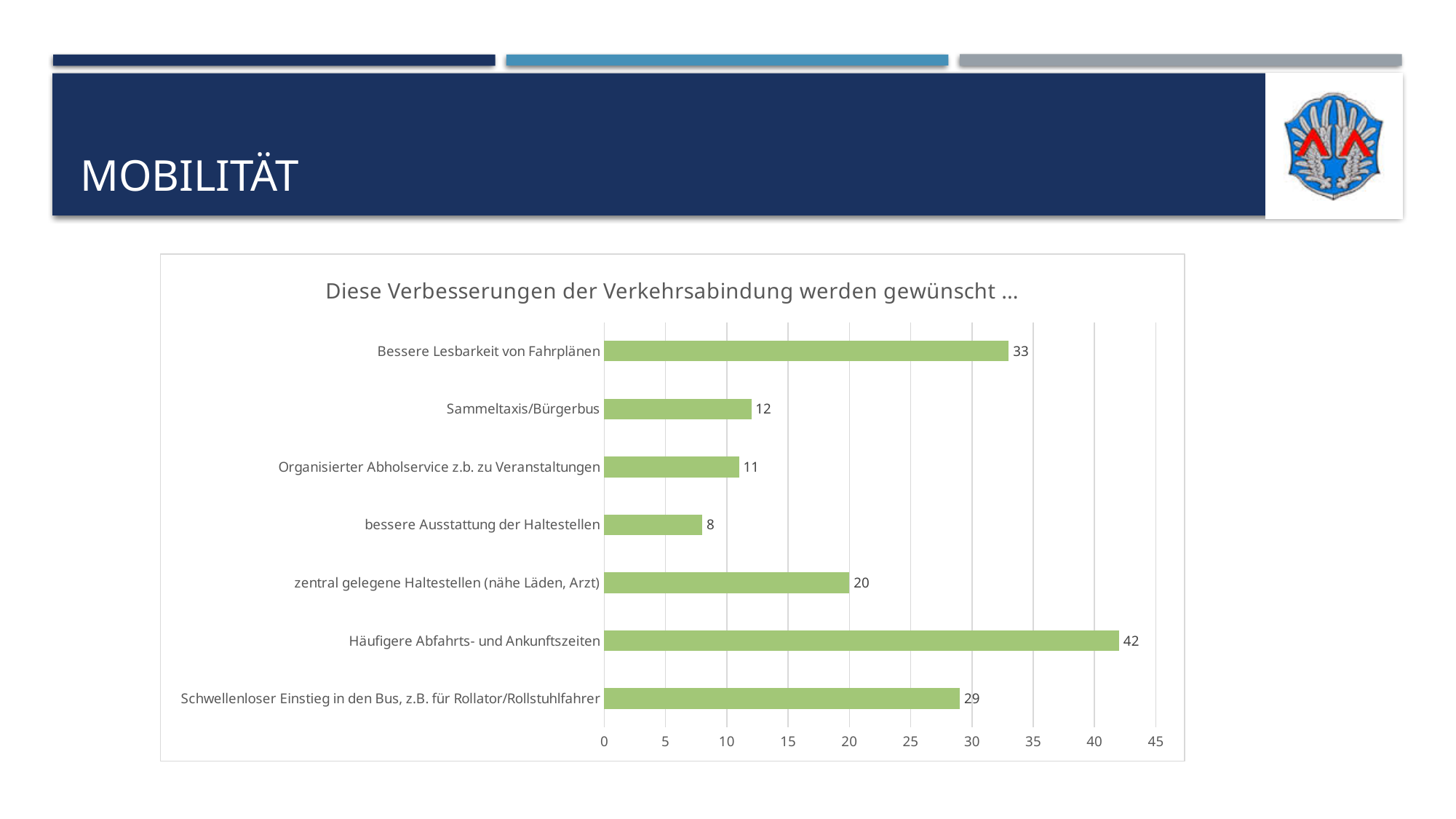
What colour are the bars in the chart? green What is the value for "Sammeltaxis/Bürgerbus"? 12 How many categories are shown in the chart? 7 Which is larger: the value for "Sammeltaxis/Bürgerbus" or for "Organisierter Abholservice z.b. zu Veranstaltungen"? Sammeltaxis/Bürgerbus What is the title of the chart? Diese Verbesserungen der Verkehrsabindung werden gewünscht … Which category has the highest value? Häufigere Abfahrts- und Ankunftszeiten What is the value for "zentral gelegene Haltestellen (nähe Läden, Arzt)"? 20 What is the difference between the values for "Häufigere Abfahrts- und Ankunftszeiten" and "Schwellenloser Einstieg in den Bus, z.B. für Rollator/Rollstuhlfahrer"? 13 What is the value for "Bessere Lesbarkeit von Fahrplänen"? 33 Which category has the lowest value? bessere Ausstattung der Haltestellen What kind of chart is shown on the slide? bar chart Is the value for "Bessere Lesbarkeit von Fahrplänen" greater or less than 30? greater